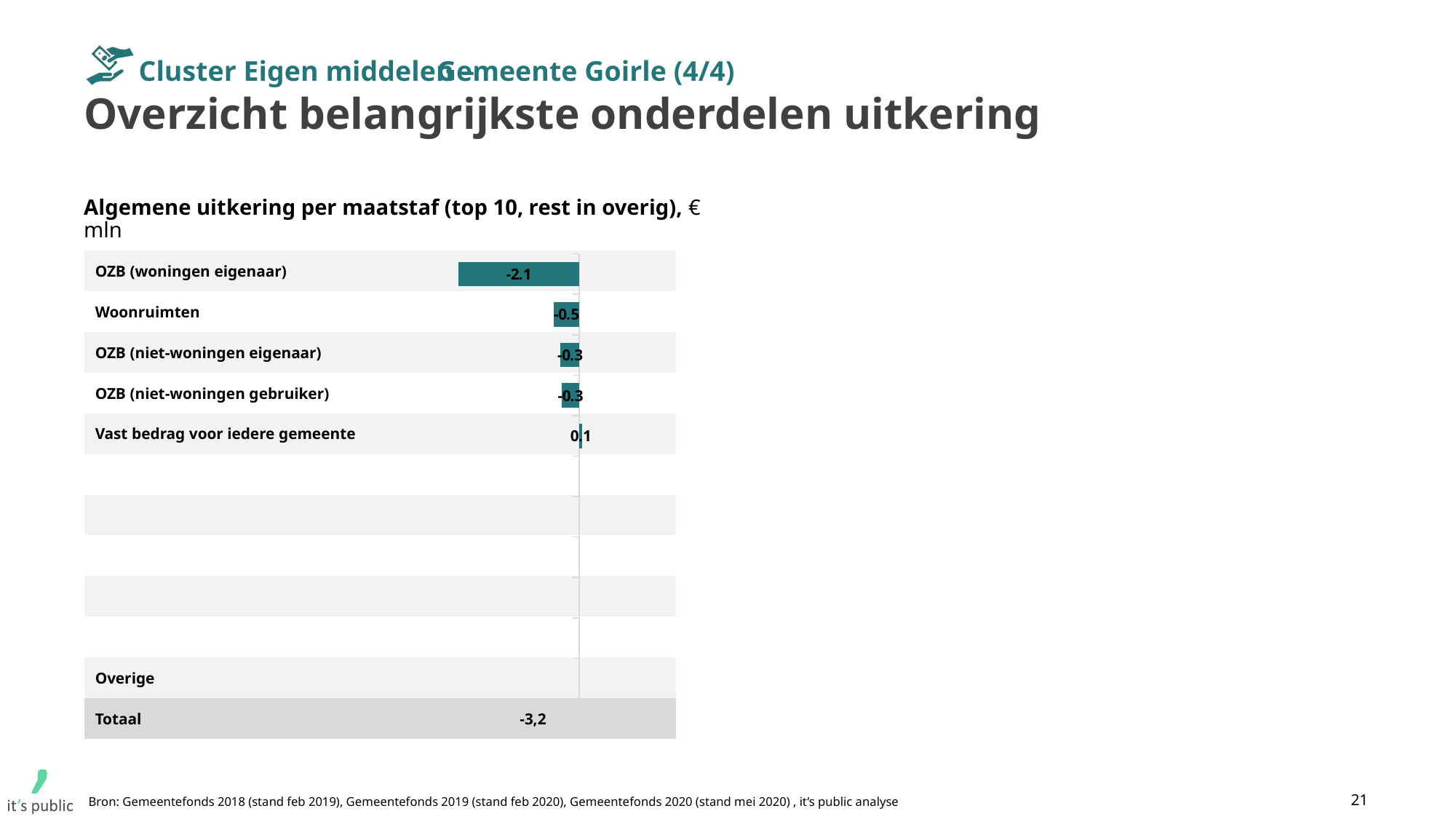
How many named categories are listed above 'Overige' in the chart? 5 What is the value for OZB (niet-woningen gebruiker)? -0.3 Which has the larger (less negative) value: Woonruimten or OZB (woningen eigenaar)? Woonruimten What is the title of the chart? Algemene uitkering per maatstaf (top 10, rest in overig), € mln What is the value shown for Totaal? -3,2 What is the value for OZB (niet-woningen eigenaar)? -0.3 What is the value for OZB (woningen eigenaar)? -2.1 What kind of chart is shown on the slide? Bar chart Which category has the most negative value? OZB (woningen eigenaar) What is the value for Woonruimten? -0.5 Which category is the only one with a positive value? Vast bedrag voor iedere gemeente What is the difference between the values for OZB (woningen eigenaar) and Woonruimten? 1.6